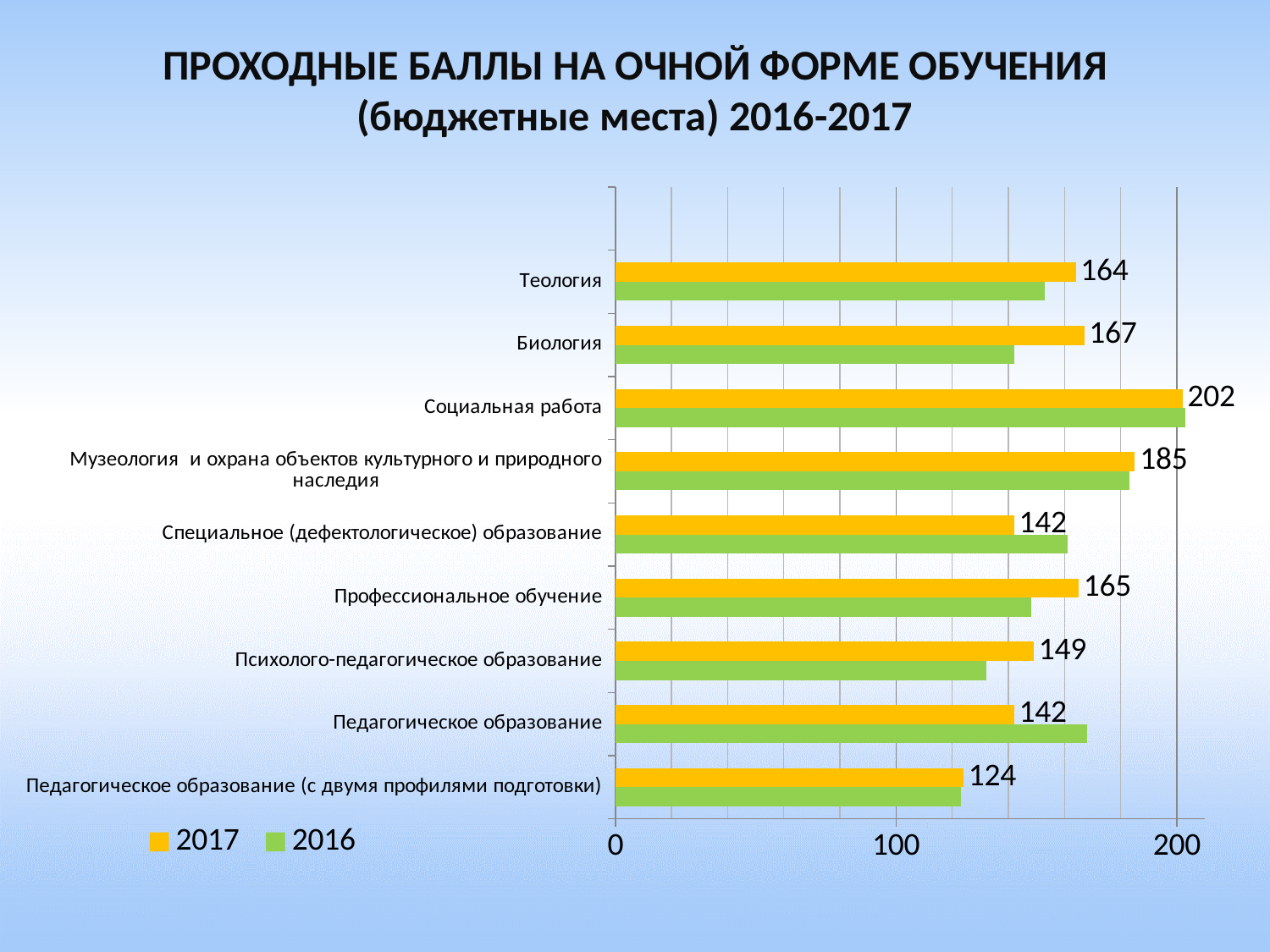
What is the 2017 value for Музеология и охрана объектов культурного и природного наследия? 185 How many categories are shown on the chart? 9 What is the 2017 value for Социальная работа? 202 What is the difference between the 2017 values for Социальная работа and Педагогическое образование (с двумя профилями подготовки)? 78 Is the 2016 value for Теология greater or less than 100? greater For Педагогическое образование, which series has the larger value, 2017 or 2016? 2016 How many series does the legend list? 2 Which category has the highest 2017 value? Социальная работа What is the 2017 value for Психолого-педагогическое образование? 149 What kind of chart is shown on the slide? bar chart Which category has the lowest 2017 value? Педагогическое образование (с двумя профилями подготовки) What is the difference between the 2017 values for Биология and Теология? 3